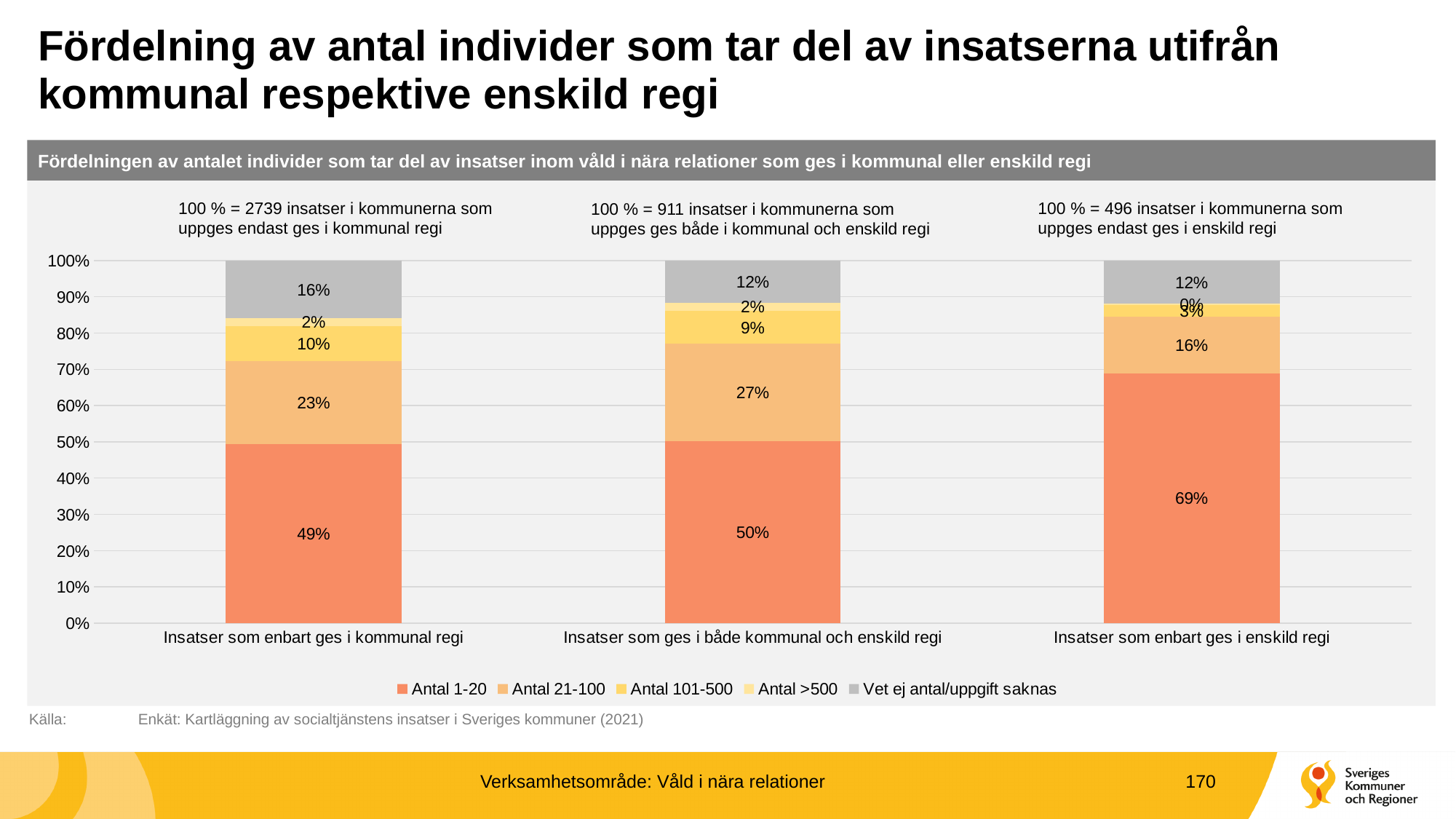
Which category has the highest value for 'Antal 1-20'? Insatser som enbart ges i enskild regi What is the value of 'Antal 21-100' for 'Insatser som ges i både kommunal och enskild regi'? 27% How many series does the legend list? 5 According to the note above the first bar, how many insatser does 100% correspond to for 'Insatser som enbart ges i kommunal regi'? 2739 What is the value of 'Antal 1-20' for 'Insatser som enbart ges i enskild regi'? 69% What kind of chart is shown on the slide? Stacked bar chart Which is larger: 'Antal 101-500' for 'Insatser som enbart ges i kommunal regi' or for 'Insatser som ges i både kommunal och enskild regi'? Insatser som enbart ges i kommunal regi What is the difference between the 'Antal 1-20' values for 'Insatser som enbart ges i enskild regi' and 'Insatser som enbart ges i kommunal regi'? 20 percentage points How many categories (bars) are shown on the x axis? 3 What is the value of 'Vet ej antal/uppgift saknas' for 'Insatser som enbart ges i kommunal regi'? 16% What is the value of 'Antal 1-20' for 'Insatser som enbart ges i kommunal regi'? 49% Which category has the lowest value for 'Antal 21-100'? Insatser som enbart ges i enskild regi